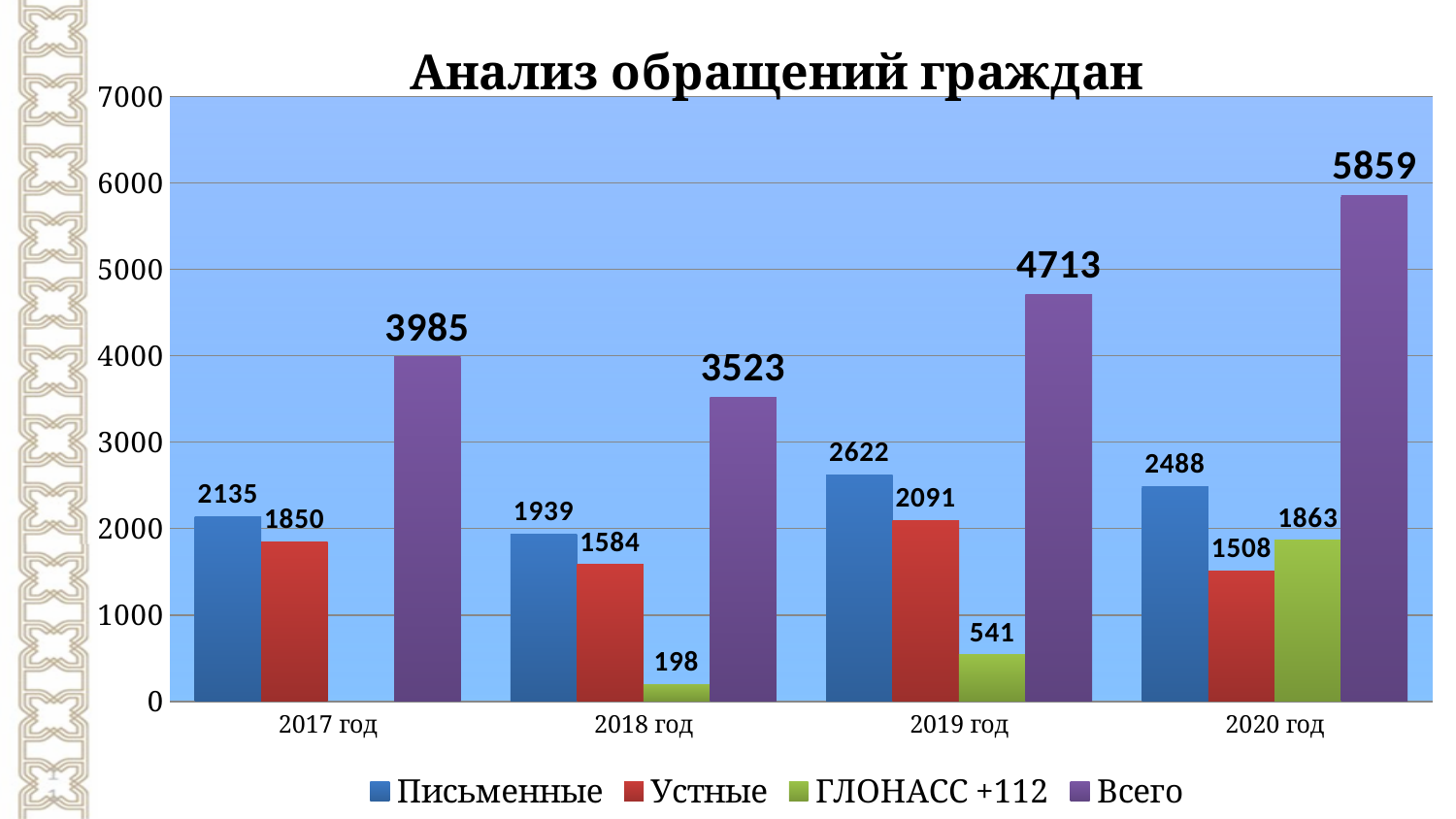
In which year is the Устные value lowest? 2020 год What is the difference between the Всего values for 2020 год and 2019 год? 1146 What is the value for Всего in 2020 год? 5859 What is the value for Устные in 2019 год? 2091 In which year is the Всего value highest? 2020 год What is the value for Письменные in 2017 год? 2135 What is the value for ГЛОНАСС +112 in 2018 год? 198 Which is larger in 2020 год: Устные or ГЛОНАСС +112? ГЛОНАСС +112 How many series does the legend list? 4 What is the title of the chart? Анализ обращений граждан What kind of chart is this? bar chart How many years are shown on the x axis? 4